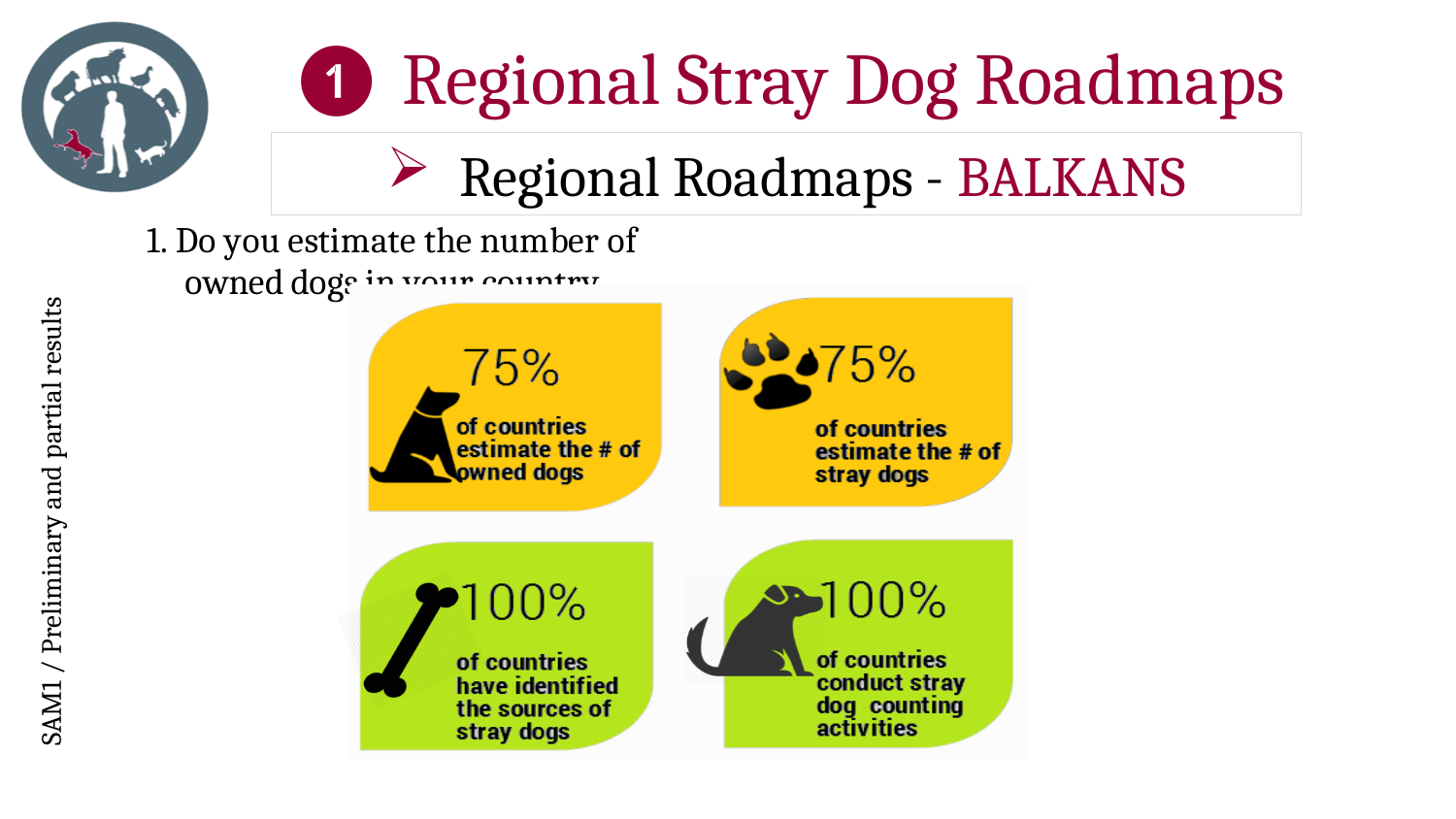
How many statistic tiles are shown in the infographic? 4 Which two statistics in the infographic have the lowest value? Countries that estimate the number of owned dogs and countries that estimate the number of stray dogs Which two statistics in the infographic are at 100%? Countries that have identified the sources of stray dogs and countries that conduct stray dog counting activities What is the difference between the share of countries that have identified the sources of stray dogs and the share that estimate the number of stray dogs? 25% What colour are the tiles showing 75%? Yellow What colour are the tiles showing 100%? Green What percentage of countries conduct stray dog counting activities? 100% Is the share of countries that estimate the number of owned dogs greater or less than 50%? greater Which is larger: the share of countries that estimate the number of owned dogs or the share that conduct stray dog counting activities? conduct stray dog counting activities What percentage of countries have identified the sources of stray dogs? 100% What percentage of countries estimate the number of stray dogs? 75% What percentage of countries estimate the number of owned dogs? 75%